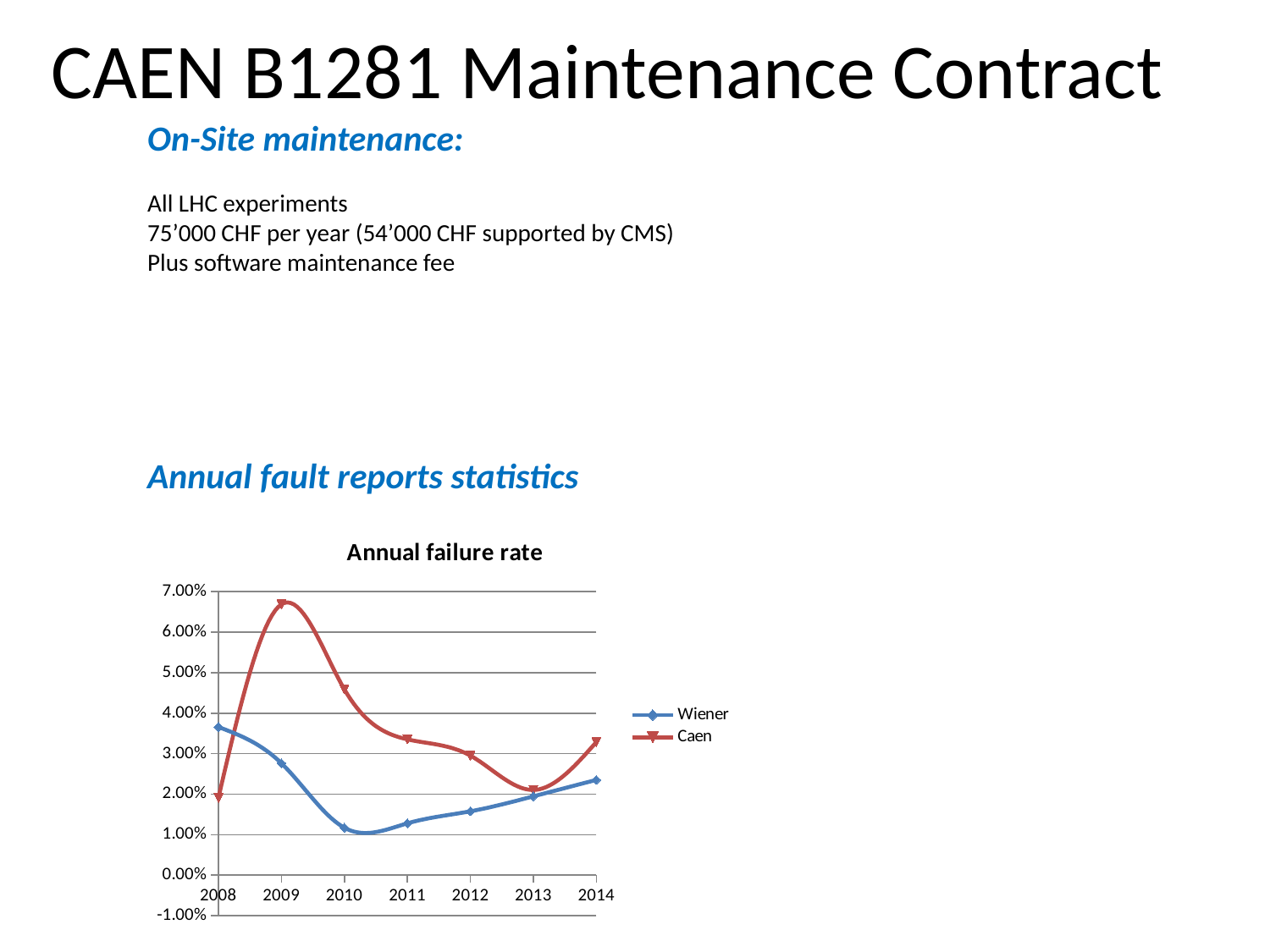
In which year does the Caen series reach its highest failure rate? 2009 Is the Caen failure rate in 2009 greater or less than 6.00%? greater Does the Wiener failure rate rise or fall from 2010 to 2014? rise In 2008, which series has the higher failure rate, Wiener or Caen? Wiener What kind of chart is the "Annual failure rate" chart? line chart What is the title of the chart on the slide? Annual failure rate In which year does the Wiener series reach its lowest failure rate? 2010 In which year does the Wiener series reach its highest failure rate? 2008 How many series does the legend of the "Annual failure rate" chart list? 2 Is the Wiener failure rate in 2010 greater or less than 2.00%? less In 2011, which series has the higher failure rate, Wiener or Caen? Caen How many years are plotted along the x axis of the "Annual failure rate" chart? 7